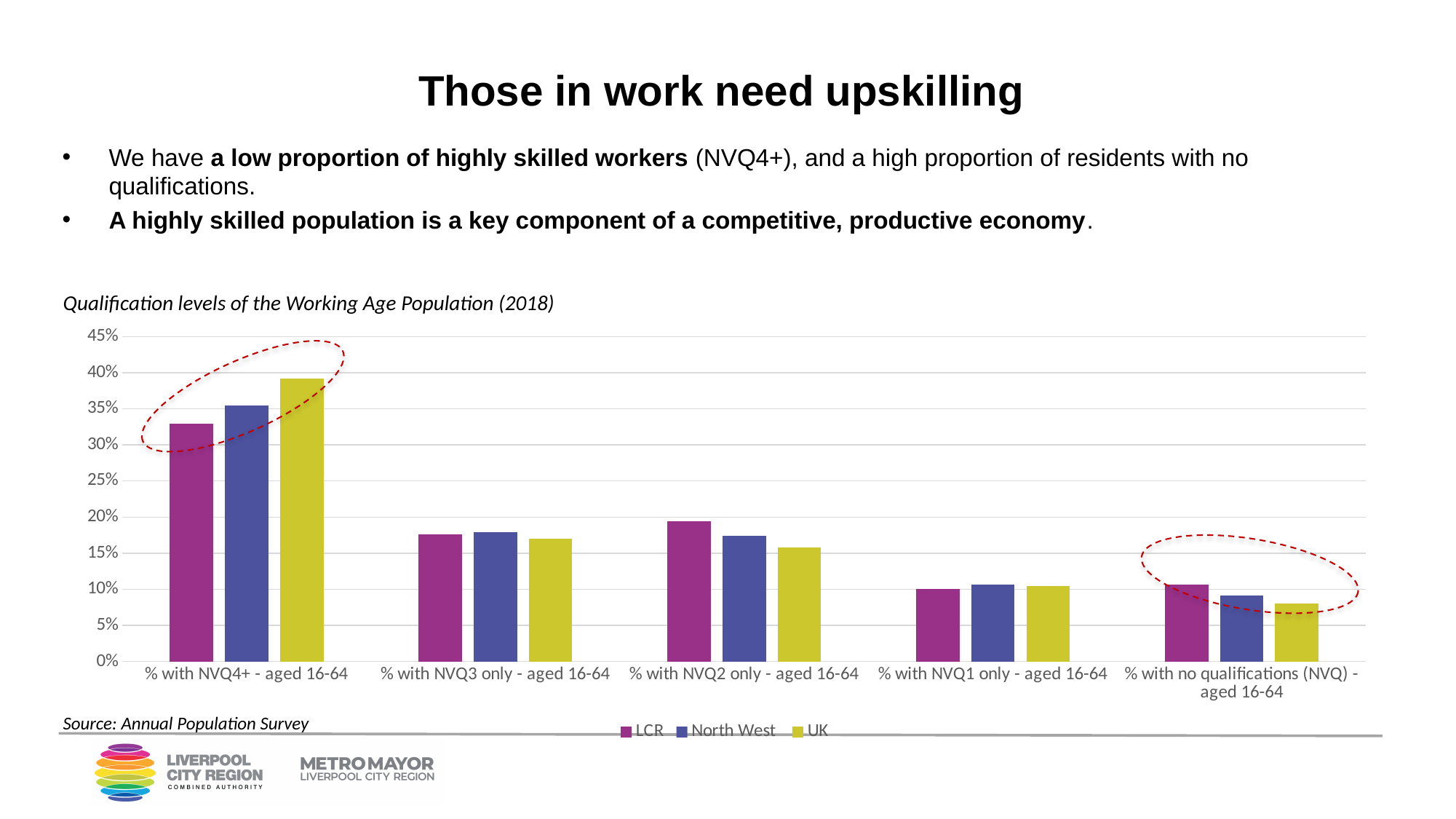
Which colour represents the UK series in the chart? Yellow What is the title of the chart? Qualification levels of the Working Age Population (2018) For '% with NVQ2 only - aged 16-64', which is larger: LCR or UK? LCR How many series does the legend list? 3 How many qualification categories are shown on the x axis? 5 Is the UK value for '% with NVQ4+ - aged 16-64' greater or less than 35%? greater Which region has the lowest value for '% with NVQ4+ - aged 16-64'? LCR Is the LCR value for '% with NVQ4+ - aged 16-64' greater or less than 30%? greater Is the UK value for '% with no qualifications (NVQ) - aged 16-64' greater or less than 10%? less What kind of chart is shown on the slide? Bar chart Which region has the highest value for '% with no qualifications (NVQ) - aged 16-64'? LCR Which region has the highest value for '% with NVQ4+ - aged 16-64'? UK